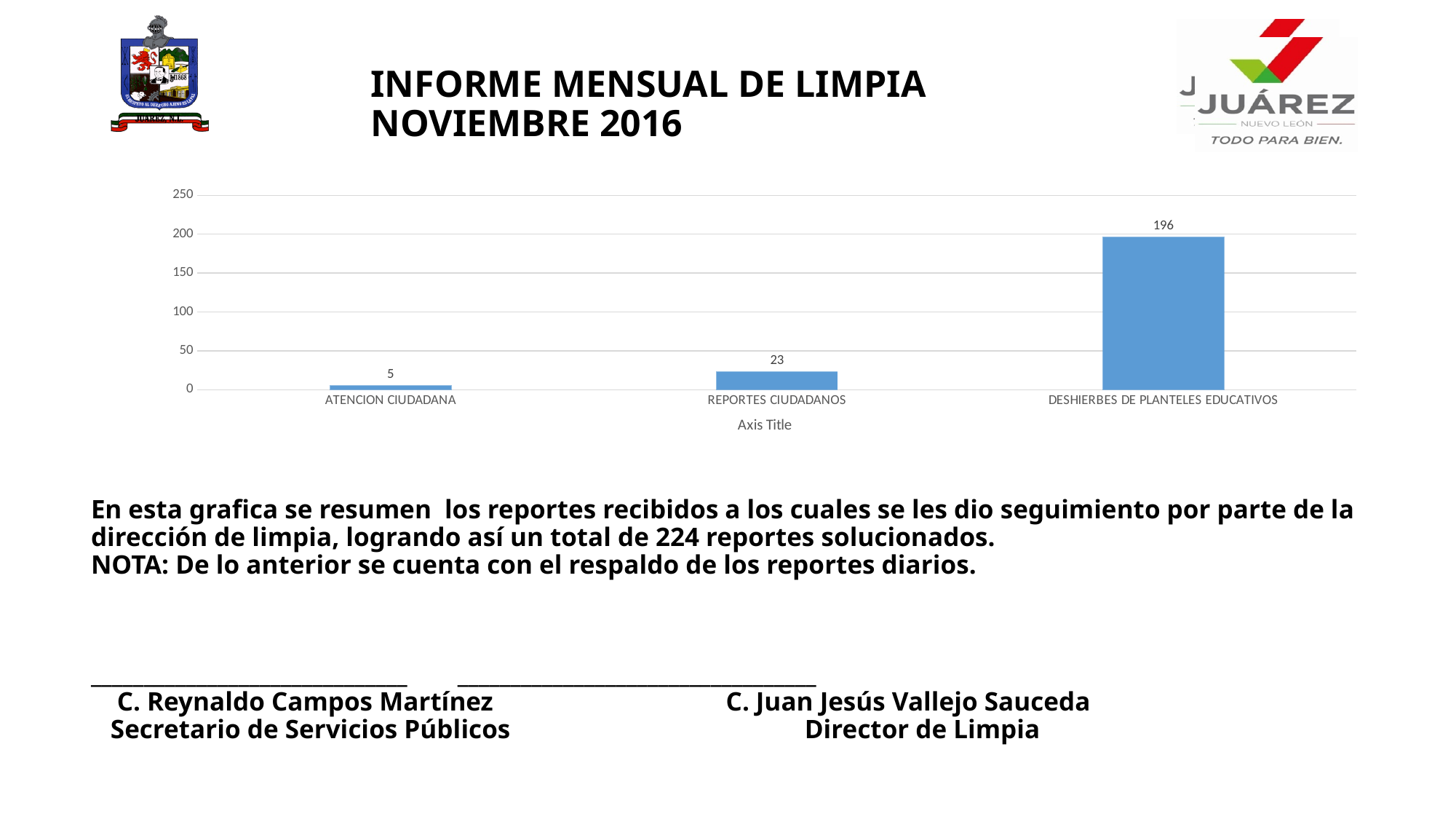
What is the label shown below the category axis of the chart? Axis Title Which is larger, the value for REPORTES CIUDADANOS or the value for ATENCION CIUDADANA? REPORTES CIUDADANOS Which category has the lowest value? ATENCION CIUDADANA What is the value for REPORTES CIUDADANOS? 23 Which category has the highest value? DESHIERBES DE PLANTELES EDUCATIVOS How many categories are shown on the chart? 3 What is the value for ATENCION CIUDADANA? 5 Is the value for DESHIERBES DE PLANTELES EDUCATIVOS greater or less than 150? greater What is the value for DESHIERBES DE PLANTELES EDUCATIVOS? 196 What is the difference between the values for REPORTES CIUDADANOS and ATENCION CIUDADANA? 18 What is the difference between the values for DESHIERBES DE PLANTELES EDUCATIVOS and REPORTES CIUDADANOS? 173 What kind of chart is shown on the slide? bar chart